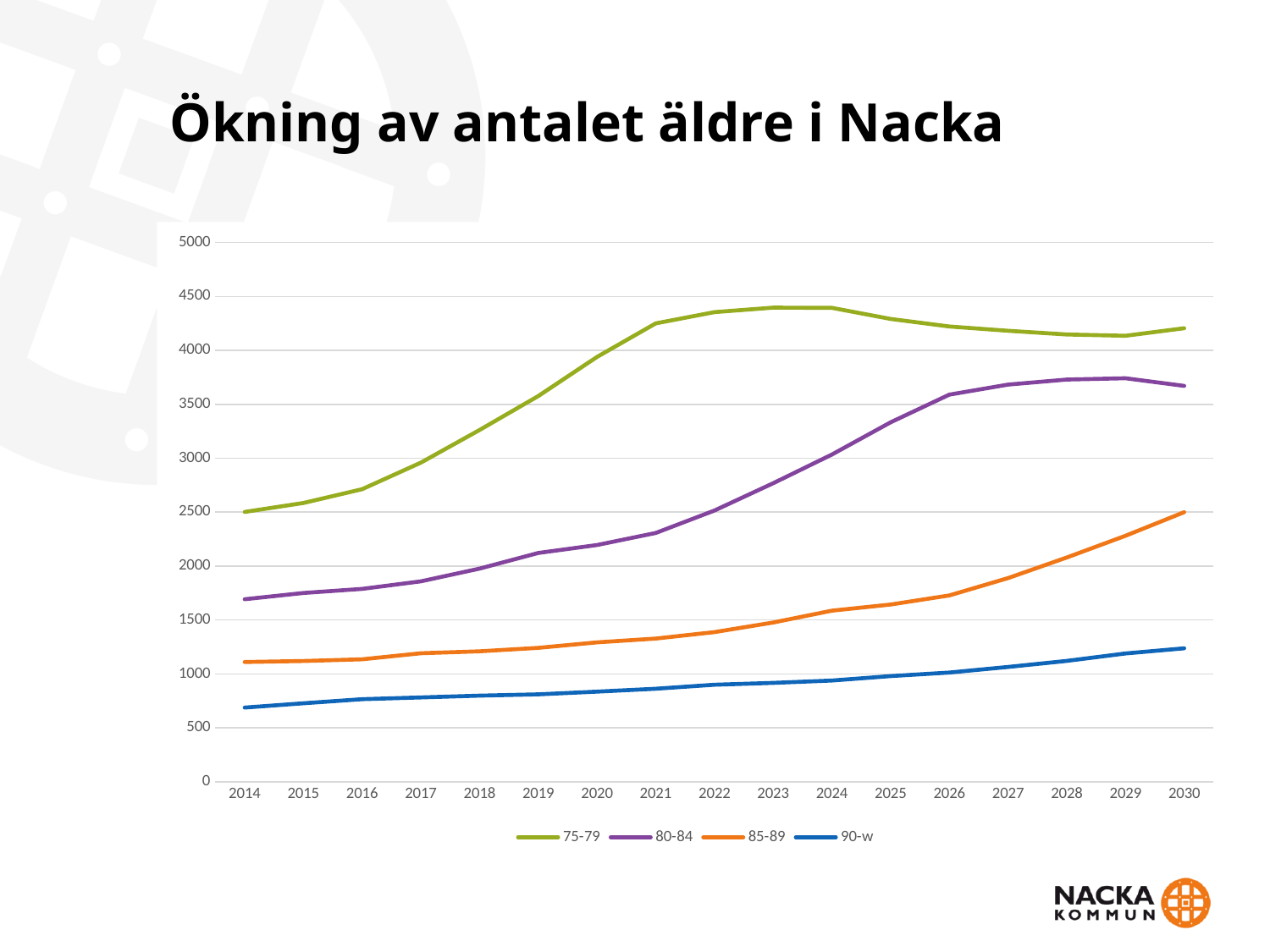
Does the 90-w line rise or fall from 2014 to 2030? Rises Is the value for 90-w in 2030 greater or less than 1000? greater How many series does the legend list? 4 Which age group has the highest values across the whole period? 75-79 Is the value for 75-79 in 2030 greater or less than 4500? less Is the value for 80-84 in 2030 greater or less than 3500? greater What is the title of the chart? Ökning av antalet äldre i Nacka Which age group has the lowest values across the whole period? 90-w How many years are shown along the x axis? 17 What kind of chart is shown on the slide? Line chart